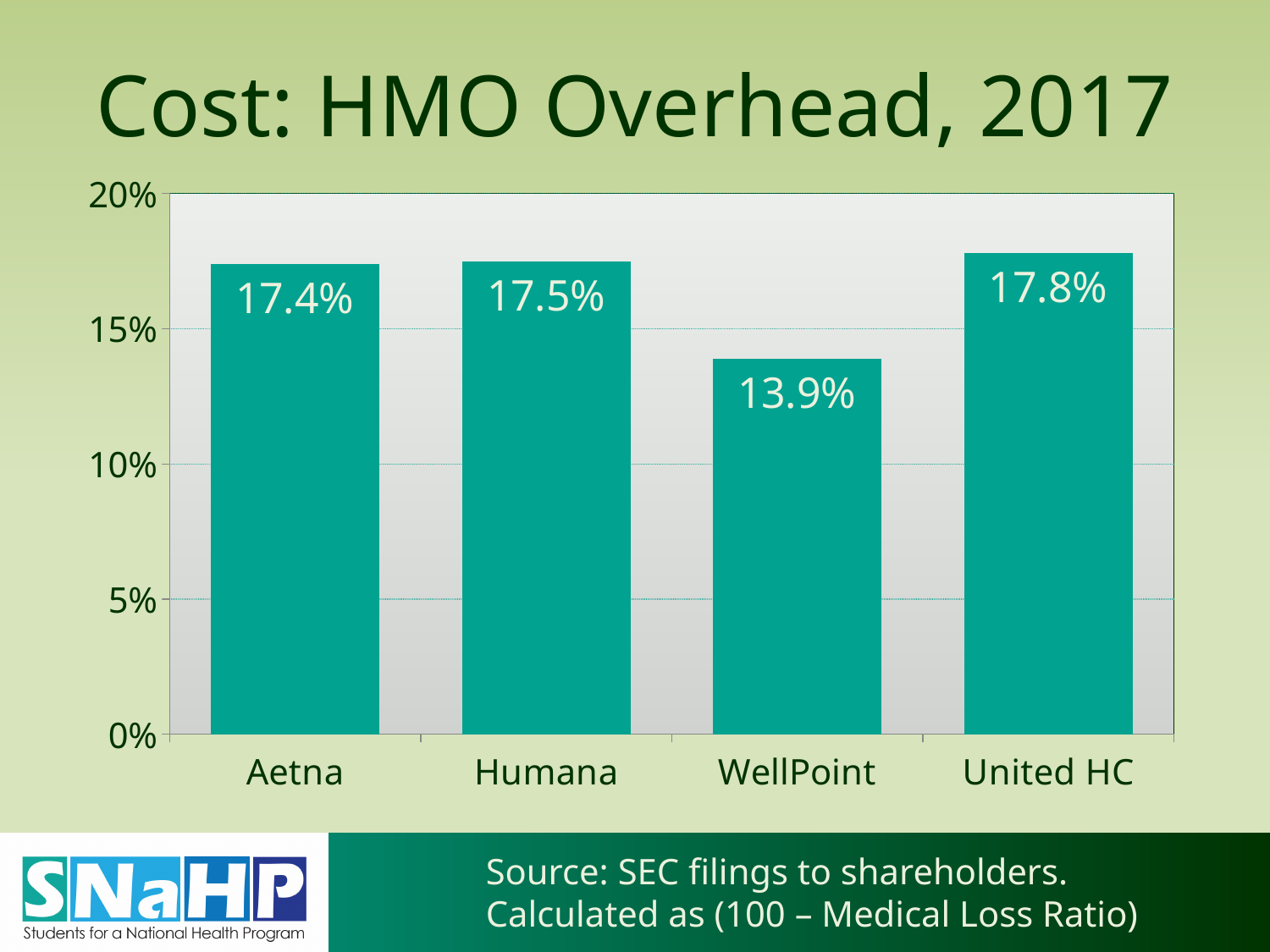
Which company has the highest overhead? United HC Is the value for WellPoint greater or less than 15%? less What is the difference between the overhead of United HC and WellPoint? 3.9% What is the title of the chart? Cost: HMO Overhead, 2017 What is the overhead value for Aetna? 17.4% What kind of chart is shown on the slide? bar chart What is the overhead value for United HC? 17.8% Which company has the lowest overhead? WellPoint What is the difference between the overhead of Humana and Aetna? 0.1% Which has a larger overhead, Humana or WellPoint? Humana How many companies are shown in the chart? 4 What is the overhead value for WellPoint? 13.9%